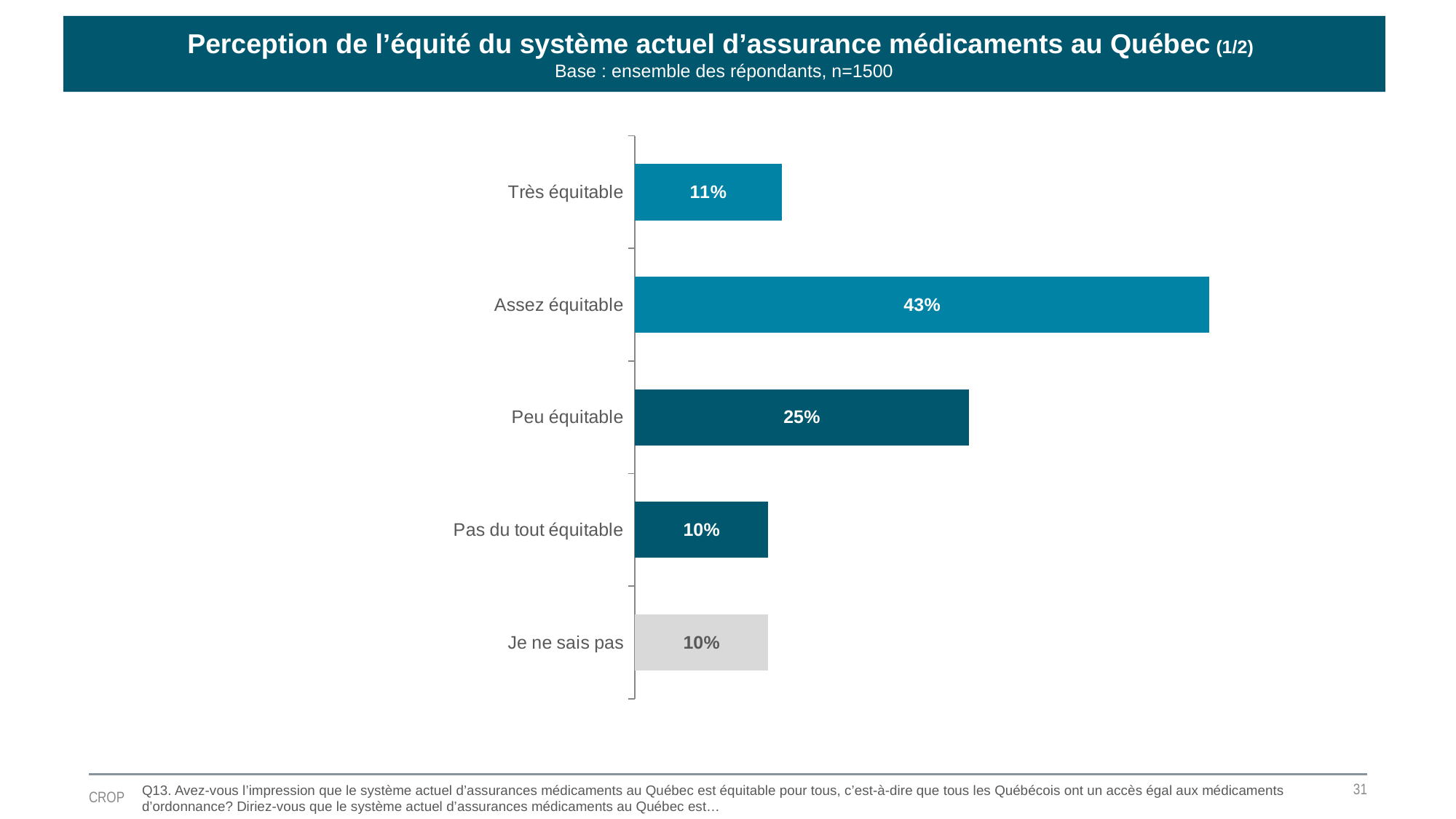
What kind of chart is shown on the slide? Bar chart Which is larger, the value for "Très équitable" or the value for "Peu équitable"? Peu équitable What is the value for "Pas du tout équitable"? 10% What is the value shown for "Assez équitable"? 43% What percentage is shown for "Peu équitable"? 25% What is the base (n) stated in the chart title? n=1500 What is the difference between "Peu équitable" and "Très équitable"? 14% What is the combined value of "Très équitable" and "Assez équitable"? 54% How many categories are shown in the chart? 5 What percentage of respondents said the system is "Très équitable"? 11% Which category has the highest value? Assez équitable What is the difference between the values for "Assez équitable" and "Peu équitable"? 18%